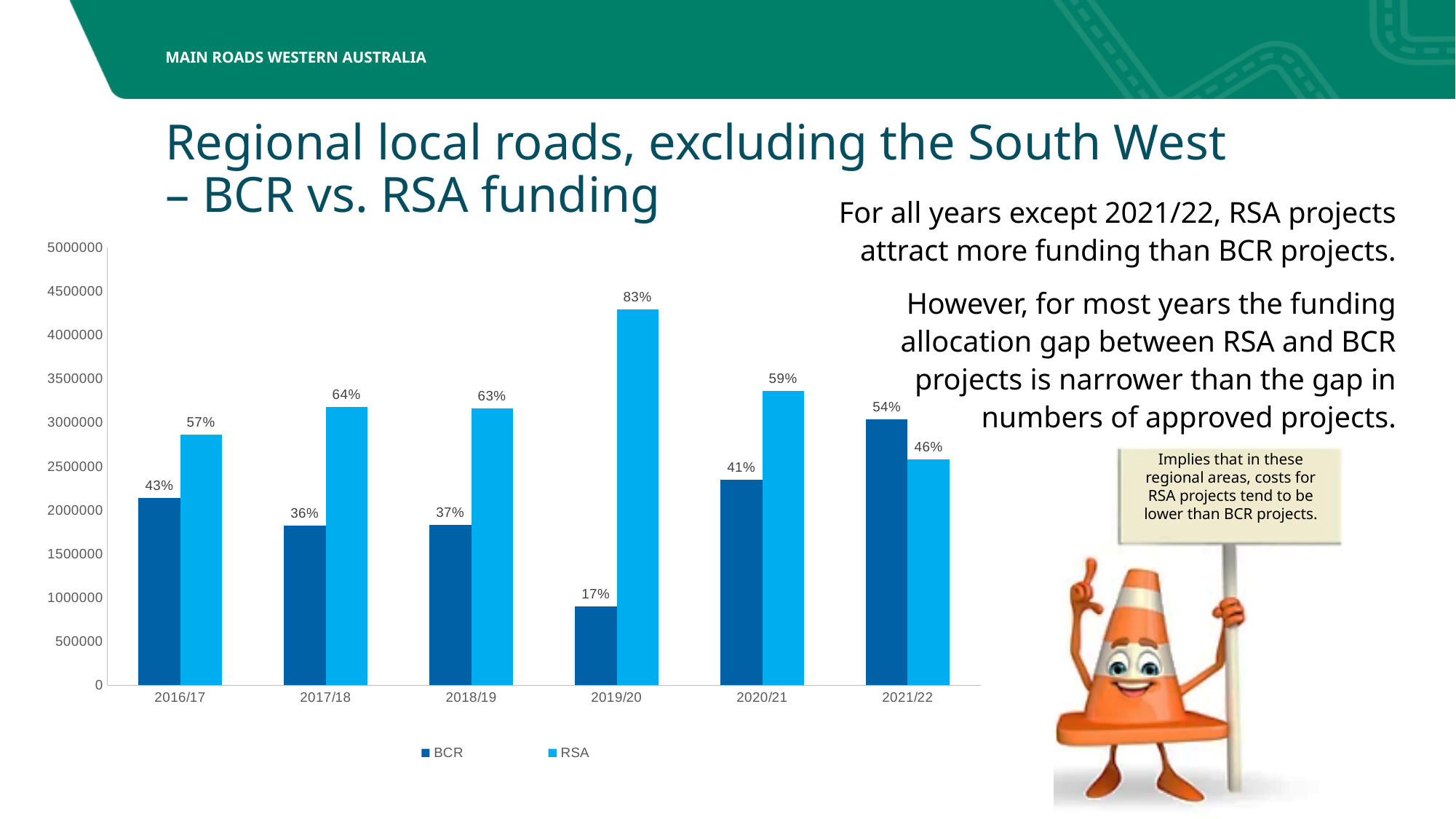
In 2021/22, which bar is taller, BCR or RSA? BCR What is the difference between the RSA and BCR percentage labels in 2019/20? 66 percentage points Is the RSA value for 2019/20 greater or less than 4000000? greater What percentage label is shown on the RSA bar for 2019/20? 83% Is the BCR value for 2019/20 greater or less than 1000000? less In which year is the RSA bar the tallest? 2019/20 How many years are shown on the x axis of the chart? 6 What percentage label is shown on the BCR bar for 2016/17? 43% What percentage label is shown on the RSA bar for 2021/22? 46% What kind of chart is shown on the slide? bar chart In which year is the BCR bar the lowest? 2019/20 How many series does the legend list? 2